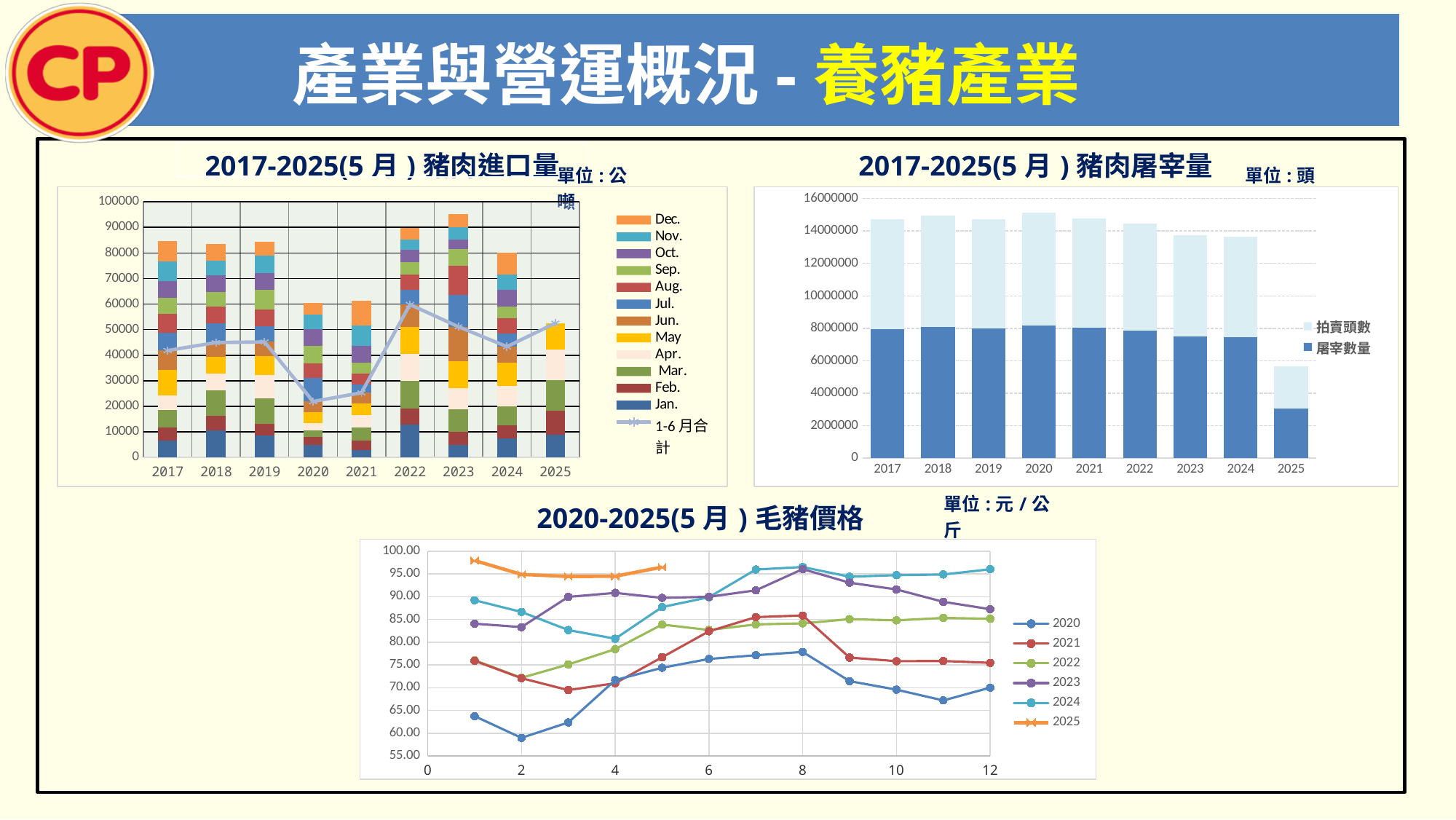
In the '2017-2025(5月) 豬肉屠宰量' chart, is the total for 2017 greater or less than 14000000? greater What kind of chart is the '2017-2025(5月) 豬肉屠宰量' chart? bar chart How many series does the legend of the '2020-2025(5月) 毛豬價格' chart list? 6 In the '2020-2025(5月) 毛豬價格' chart, which is larger at month 8: the 2024 value or the 2020 value? 2024 What kind of chart is the '2020-2025(5月) 毛豬價格' chart? line chart How many years are shown on the x axis of the '2017-2025(5月) 豬肉進口量' chart? 9 How many series does the legend of the '2017-2025(5月) 豬肉屠宰量' chart list? 2 In the '2017-2025(5月) 豬肉進口量' chart, which year has the tallest stacked bar? 2023 In the '2020-2025(5月) 毛豬價格' chart, is the 2020 value at month 2 greater or less than 60.00? less In the '2017-2025(5月) 豬肉屠宰量' chart, which year has the shortest stacked bar? 2025 In the '2017-2025(5月) 豬肉屠宰量' chart, is the total for 2025 greater or less than 6000000? less